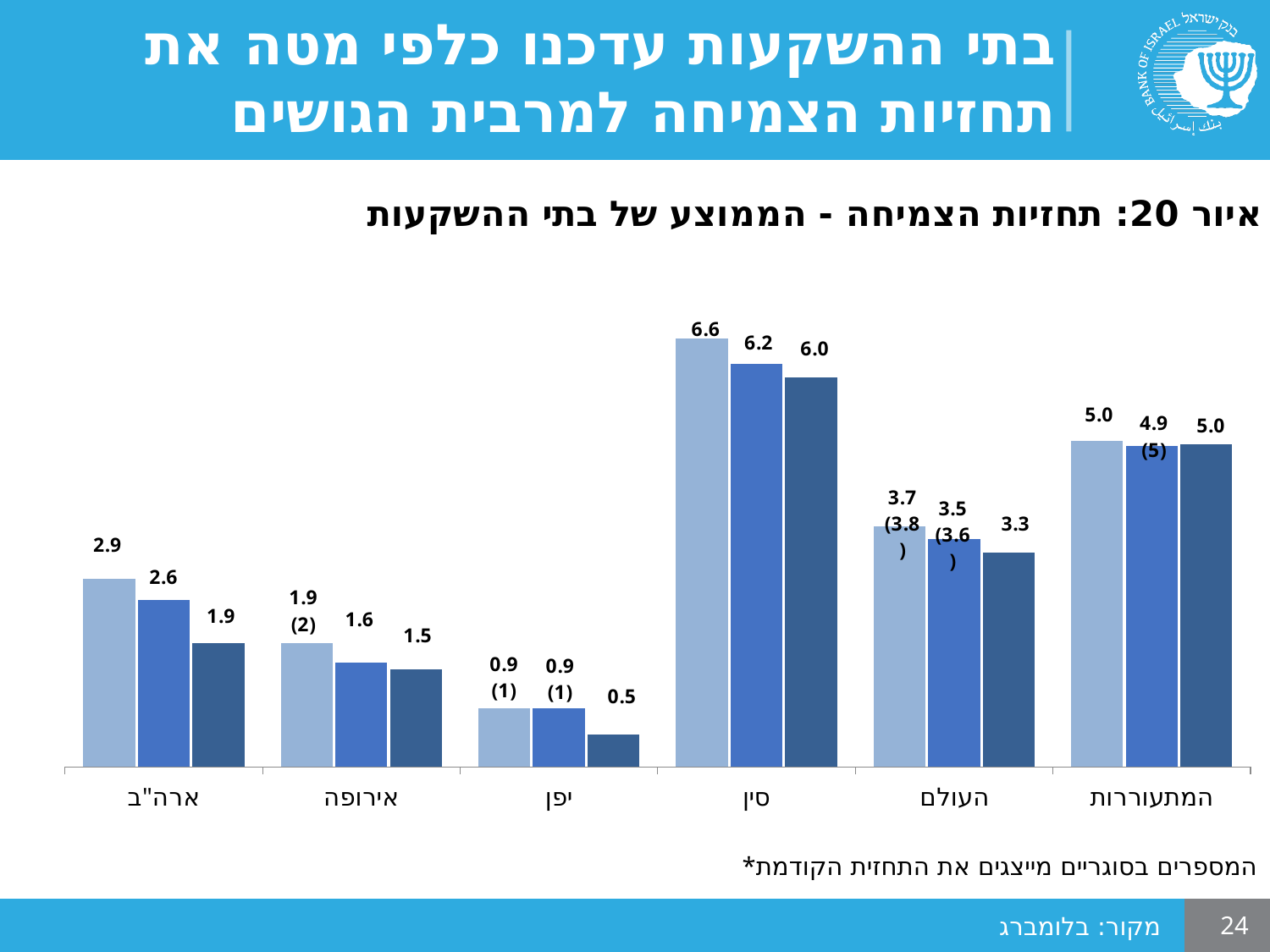
What is the value of the rightmost (dark blue) bar for ארה"ב? 1.9 What is the difference between the leftmost bar and the rightmost bar for סין? 0.6 How many bars are shown for each category? 3 Which is larger: the leftmost bar for המתעוררות or the leftmost bar for העולם? המתעוררות Which category has the lowest bars in the chart? יפן What is the title of the chart? איור 20: תחזיות הצמיחה - הממוצע של בתי ההשקעות What is the difference between the leftmost bar and the rightmost bar for ארה"ב? 1.0 What is the value of the leftmost (light blue) bar for סין? 6.6 What kind of chart is shown on the slide? bar chart Which category has the highest bars in the chart? סין What is the value of the middle bar for העולם? 3.5 How many categories are shown on the x axis? 6